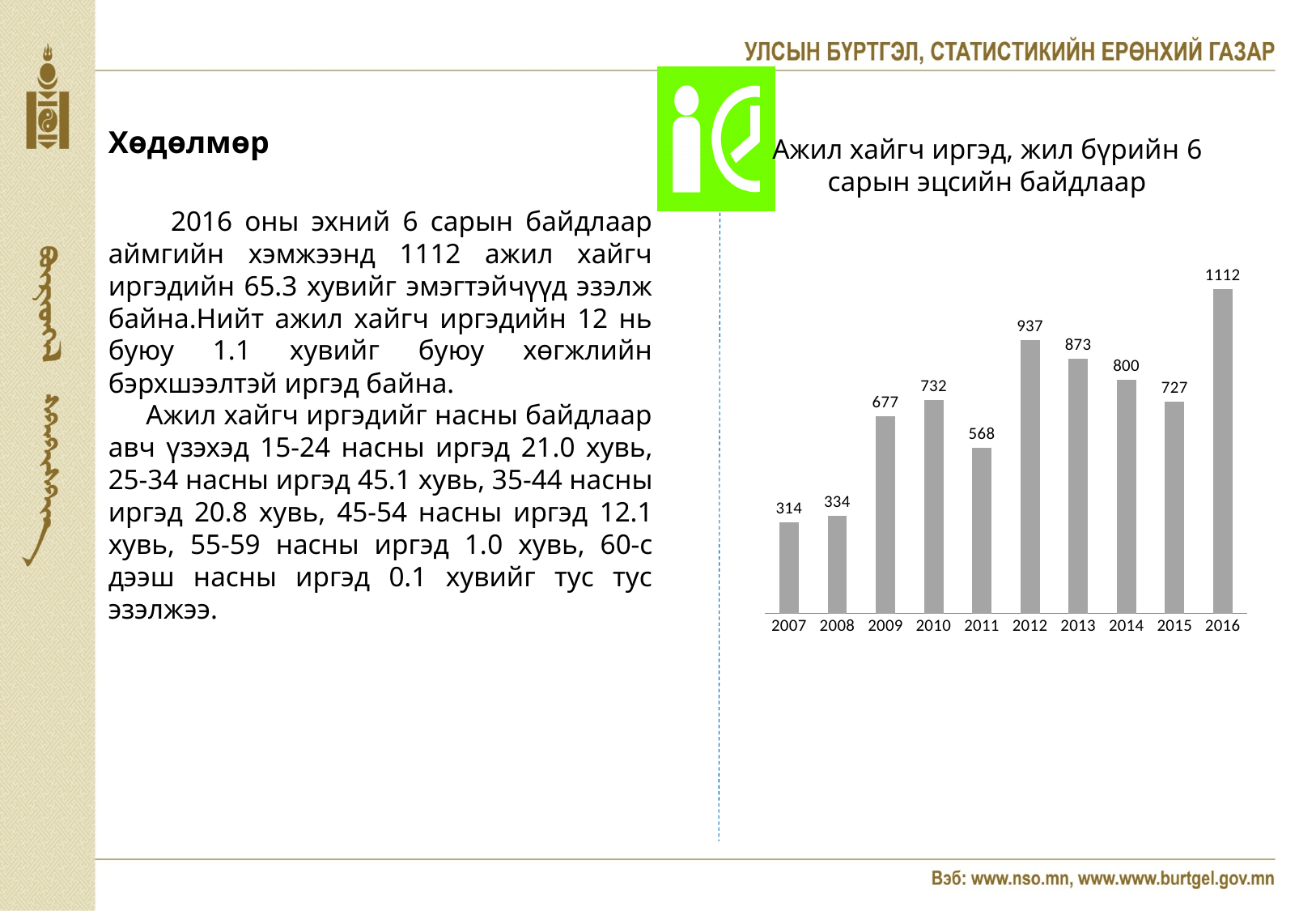
Which is larger, the value for 2013 or the value for 2014? 2013 What kind of chart is this? bar chart Do the values rise or fall from 2007 to 2010? rise What is the difference between the values for 2012 and 2011? 369 What is the value for 2015? 727 What is the title of the chart? Ажил хайгч иргэд, жил бүрийн 6 сарын эцсийн байдлаар What is the difference between the values for 2016 and 2015? 385 How many years are shown on the x axis? 10 Which year has the lowest value? 2007 What is the value for 2007? 314 Which year has the highest value? 2016 What is the value for 2012? 937